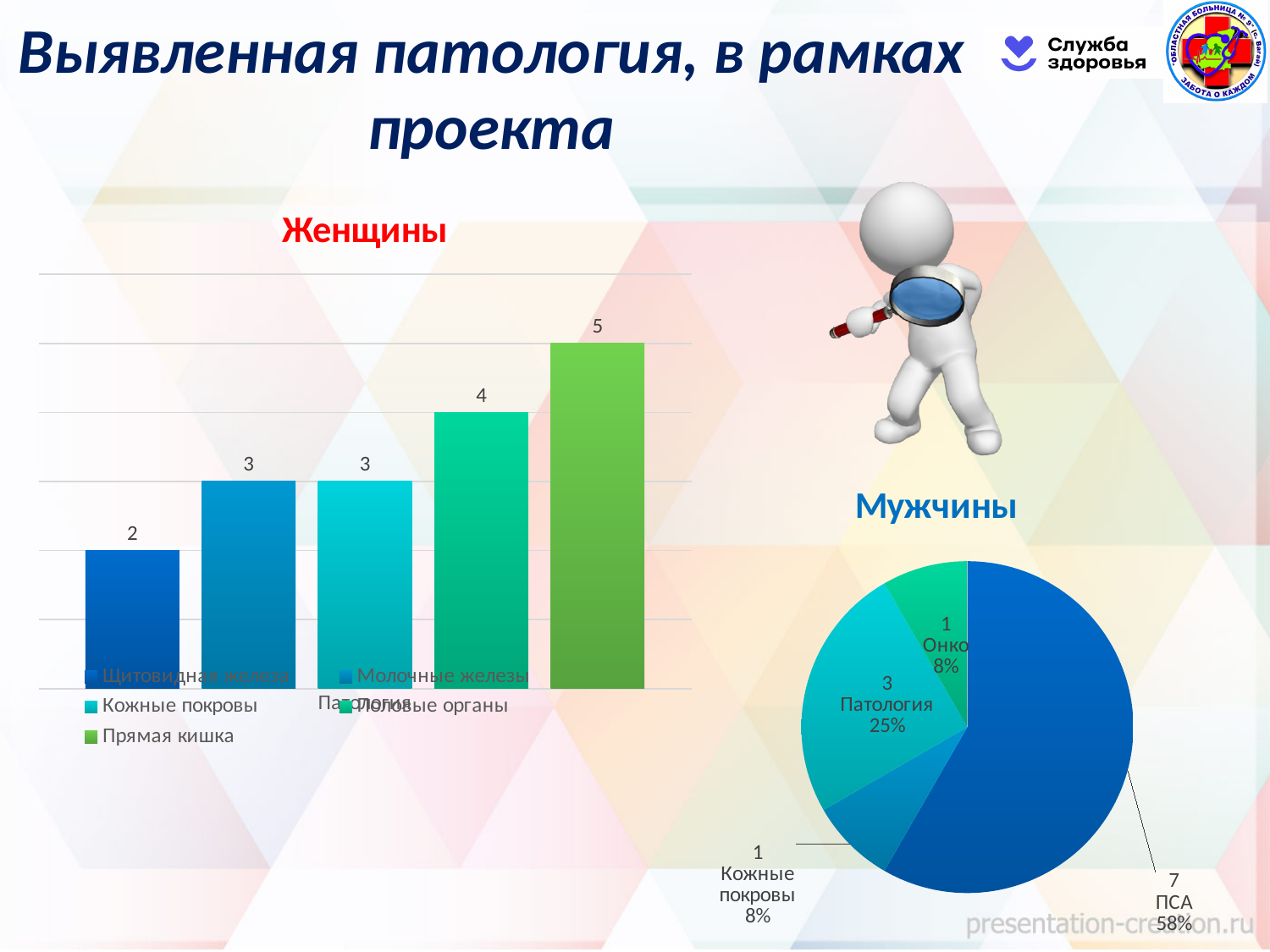
On the "Мужчины" chart, what share of the pie does ПСА take? 58% On the "Мужчины" chart, what is the value for Патология? 3 On the "Женщины" chart, how many bars are plotted? 5 On the "Мужчины" chart, which slice is the largest? ПСА On the "Женщины" chart, what is the difference between the values for Прямая кишка and Щитовидная железа? 3 On the "Женщины" chart, which category has the lowest value? Щитовидная железа What kind of chart is the "Мужчины" chart? pie chart On the "Женщины" chart, what is the value for Прямая кишка? 5 On the "Женщины" chart, what is the value for Щитовидная железа? 2 On the "Женщины" chart, do the values rise or fall from left to right? rise What kind of chart is the "Женщины" chart? bar chart On the "Женщины" chart, which category has the highest value? Прямая кишка